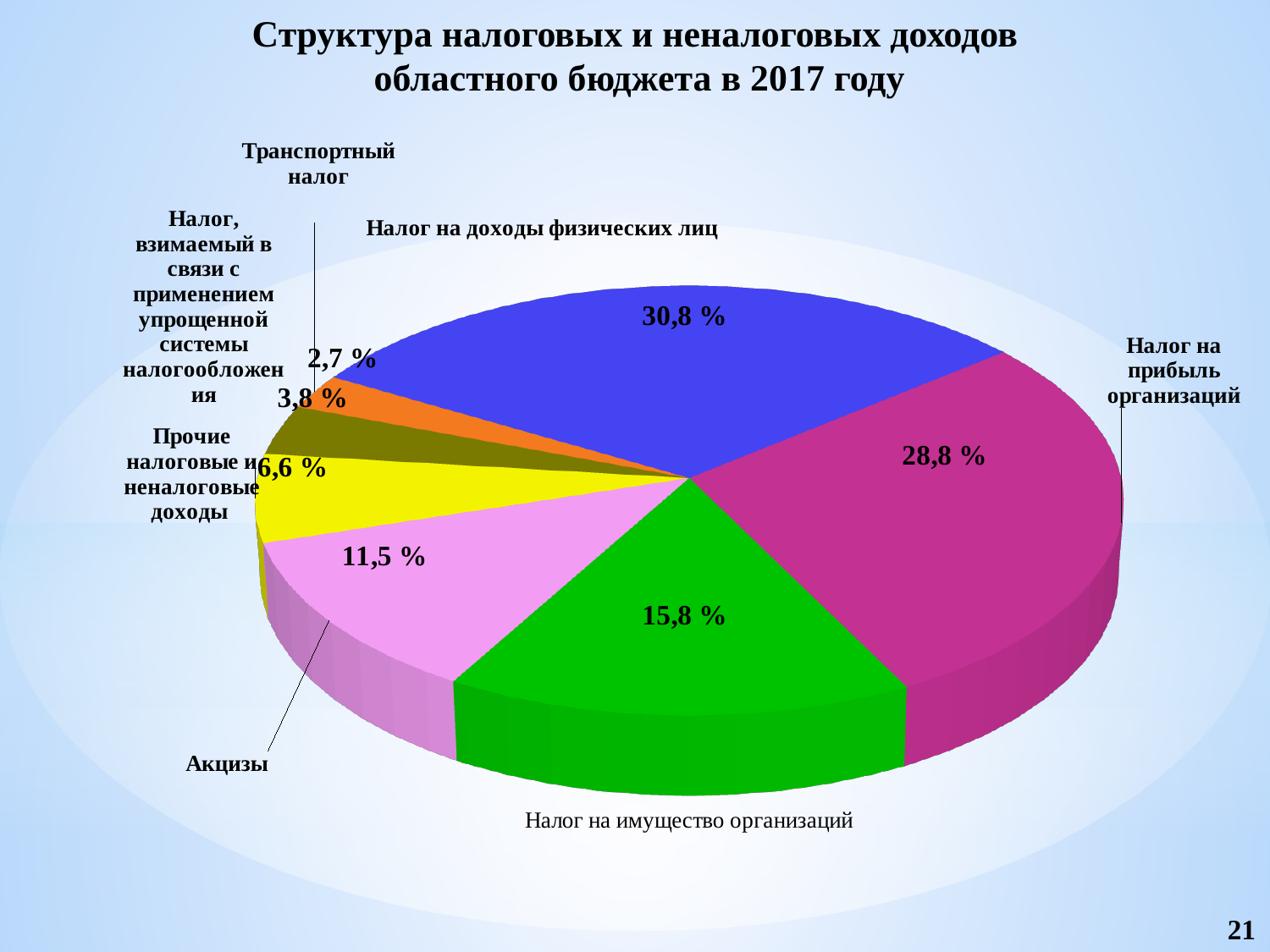
Which is larger: the share of "Акцизы" or the share of "Прочие налоговые и неналоговые доходы"? Акцизы Which category has the smallest share of the pie? Транспортный налог What is the difference between the shares of "Налог на доходы физических лиц" and "Налог на прибыль организаций"? 2,0 % What share of the pie does "Транспортный налог" have? 2,7 % What kind of chart is shown on the slide? pie chart What is the title of the chart? Структура налоговых и неналоговых доходов областного бюджета в 2017 году Which category has the largest share of the pie? Налог на доходы физических лиц How many slices does the pie chart have? 7 What share of the pie does "Акцизы" have? 11,5 % What share of the pie does "Налог на доходы физических лиц" have? 30,8 % What share of the pie does "Налог на прибыль организаций" have? 28,8 % What share of the pie does "Налог на имущество организаций" have? 15,8 %